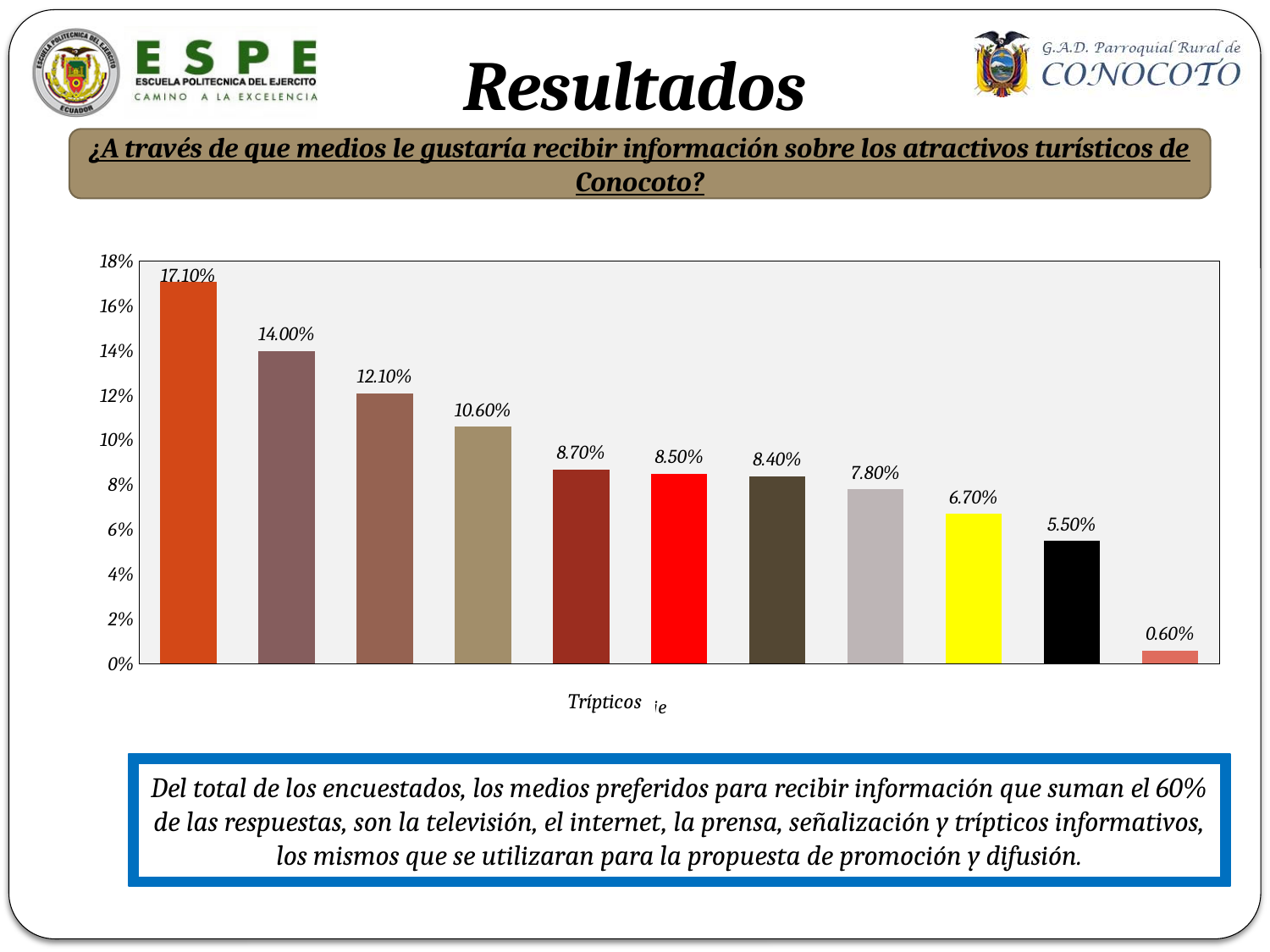
How many bars are plotted in the chart? 11 What is the value shown on the shortest bar in the chart? 0.60% What is the value of the bright red bar in the chart? 8.50% What kind of chart is shown on the slide? bar chart What is the value of the black bar in the chart? 5.50% What is the value of the second bar from the left in the chart? 14.00% What is the highest value shown on the chart's vertical axis? 18% What is the difference between the first bar (17.10%) and the second bar (14.00%) in the chart? 3.10% What is the value of the yellow bar in the chart? 6.70% What is the value shown on the tallest bar in the chart? 17.10% Which is larger in the chart: the fourth bar from the left or the fifth bar from the left? the fourth bar (10.60%) Do the bar values rise or fall from left to right across the chart? fall